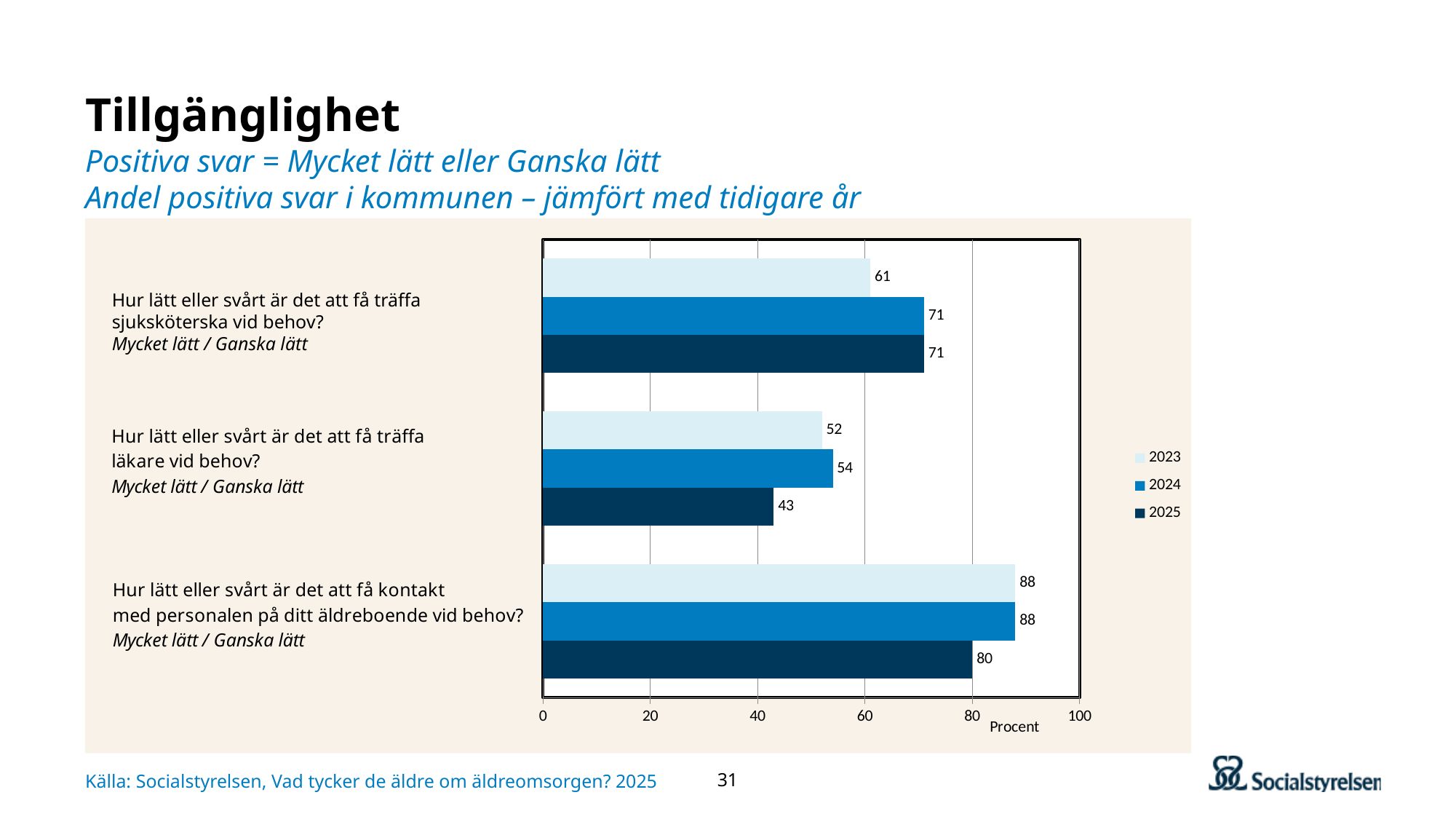
How many series does the legend list? 3 How many questions (categories) are shown on the chart? 3 What kind of chart is shown on the slide? bar chart What is the 2024 value for 'Hur lätt eller svårt är det att få kontakt med personalen på ditt äldreboende vid behov?' 88 What is the difference between the 2023 and 2025 values for 'Hur lätt eller svårt är det att få kontakt med personalen på ditt äldreboende vid behov?' 8 What is the 2025 value for 'Hur lätt eller svårt är det att få träffa läkare vid behov?' 43 What is the difference between the 2024 and 2025 values for 'Hur lätt eller svårt är det att få träffa läkare vid behov?' 11 For 'Hur lätt eller svårt är det att få träffa sjuksköterska vid behov?', is the 2024 value larger or smaller than the 2023 value? larger Which question has the highest 2025 value? Hur lätt eller svårt är det att få kontakt med personalen på ditt äldreboende vid behov? What is the label on the horizontal axis of the chart? Procent Which question has the lowest 2024 value? Hur lätt eller svårt är det att få träffa läkare vid behov? What is the 2023 value for 'Hur lätt eller svårt är det att få träffa sjuksköterska vid behov?' 61